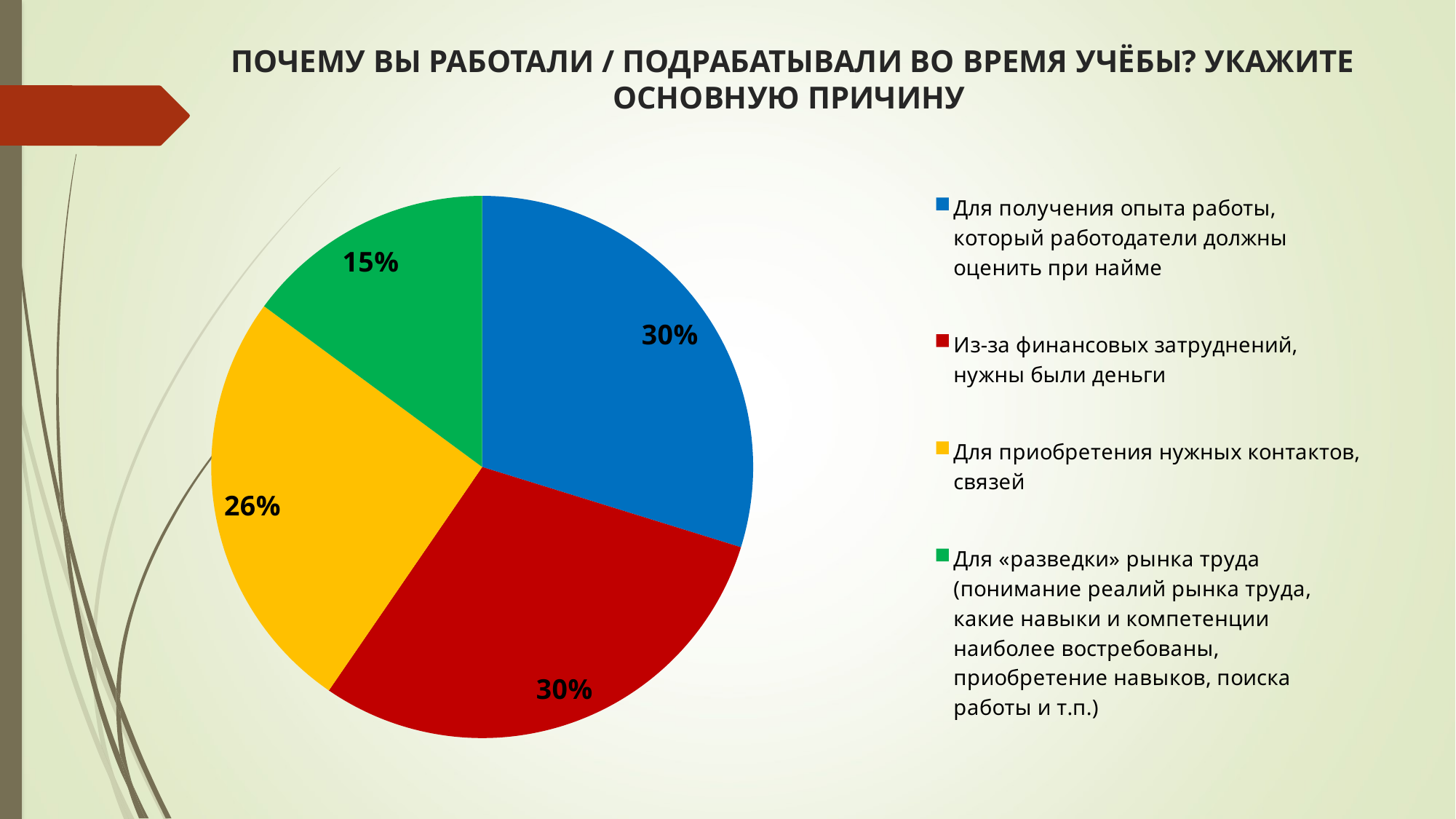
What kind of chart is shown on the slide? Pie chart What percentage is shown for "Для приобретения нужных контактов, связей"? 26% How many slices does the pie chart have? 4 What percentage is shown for "Для получения опыта работы, который работодатели должны оценить при найме"? 30% What is the title of the slide? Почему вы работали / подрабатывали во время учёбы? Укажите основную причину What percentage is shown for "Для «разведки» рынка труда"? 15% What colour is the slice for "Для приобретения нужных контактов, связей"? Yellow Which reason has the smallest slice of the pie? Для «разведки» рынка труда What share of the pie is labelled for "Из-за финансовых затруднений, нужны были деньги"? 30% Which is larger: the slice for "Из-за финансовых затруднений, нужны были деньги" or the slice for "Для приобретения нужных контактов, связей"? Из-за финансовых затруднений, нужны были деньги What is the difference in percentage points between "Для приобретения нужных контактов, связей" and "Для «разведки» рынка труда"? 11 How many entries does the legend list? 4